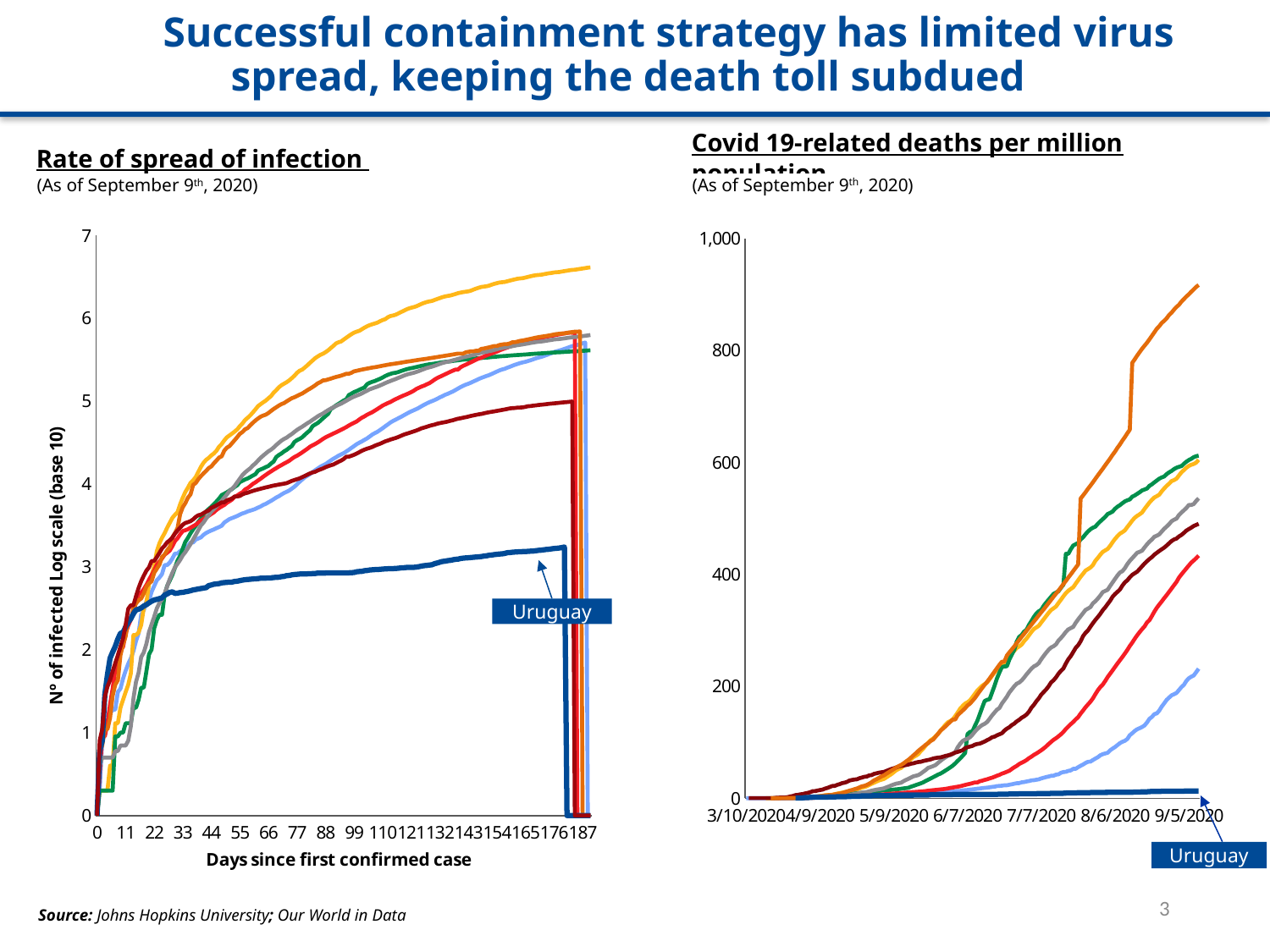
In the right chart 'Covid 19-related deaths per million population', do the lines generally rise or fall from 3/10/2020 to 9/5/2020? rise What kind of chart is the right chart titled 'Covid 19-related deaths per million population'? line chart In the left chart 'Rate of spread of infection', is the value for Uruguay at day 165 greater or less than 4? less Which country is labelled with a callout on both charts? Uruguay In the left chart 'Rate of spread of infection', does the Uruguay line rise or fall between day 0 and day 165? rise In the right chart 'Covid 19-related deaths per million population', is the value for Uruguay on 9/5/2020 greater or less than 200? less What is the x-axis title of the left chart 'Rate of spread of infection'? Days since first confirmed case In the left chart 'Rate of spread of infection', is the value for Uruguay at day 165 greater or less than 2? greater What kind of chart is the left chart titled 'Rate of spread of infection'? line chart